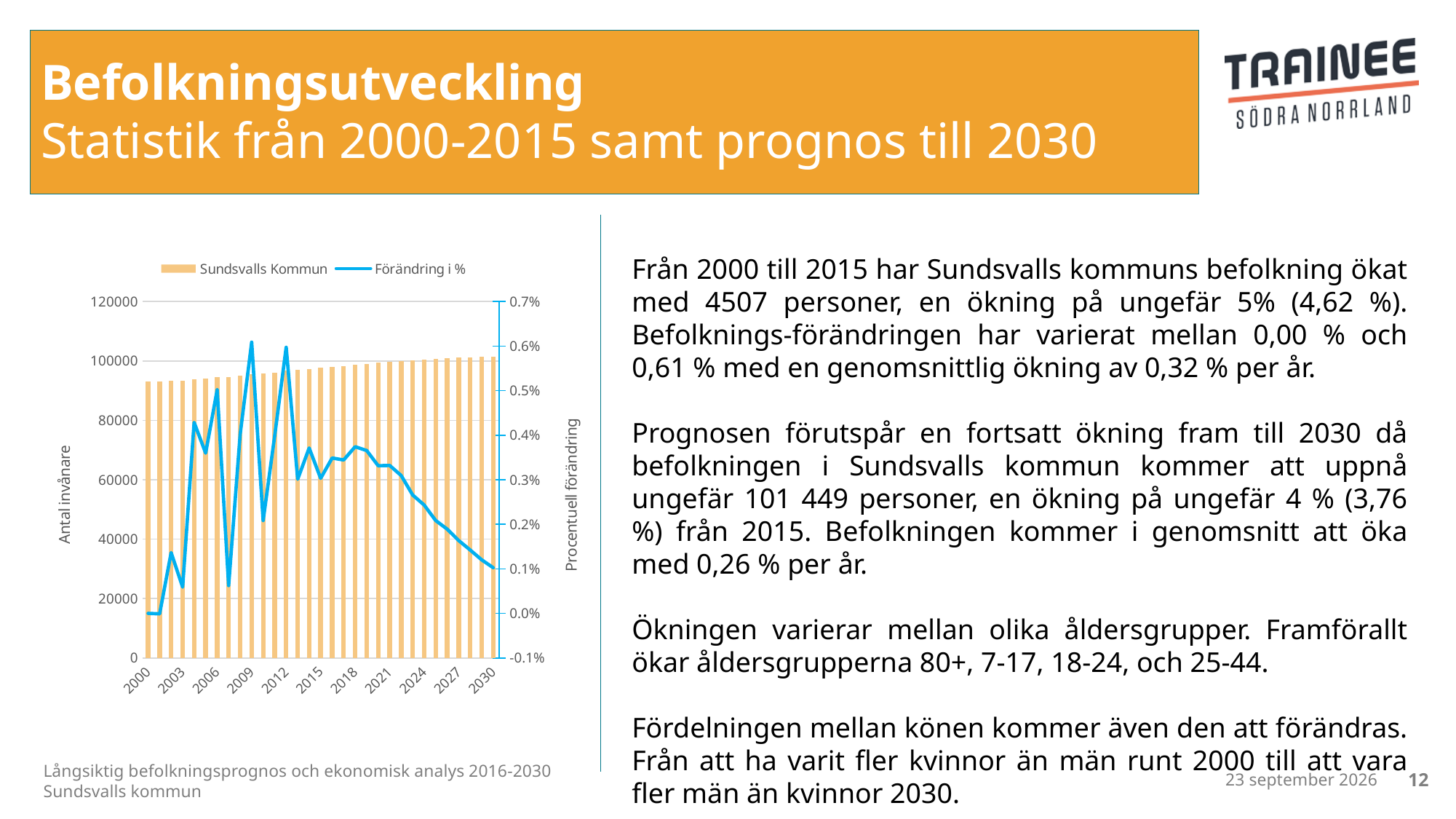
Do the population bars (Sundsvalls Kommun) rise or fall from 2000 to 2030? rise How many series does the chart legend list? 2 Is the Förändring i % value for 2009 greater or less than 0.5%? greater Is the Förändring i % value for 2030 greater or less than 0.2%? less Is the population bar (Sundsvalls Kommun) for 2000 greater or less than 80000? greater Which is larger, the population bar for 2000 or the population bar for 2030? 2030 What kind of chart is shown on the slide? A combined bar and line chart Does the Förändring i % line rise or fall from 2018 to 2030? fall What is the title of the left vertical axis of the chart? Antal invånare What are the two series named in the chart legend? Sundsvalls Kommun and Förändring i % Which is larger, the Förändring i % value for 2009 or for 2030? 2009